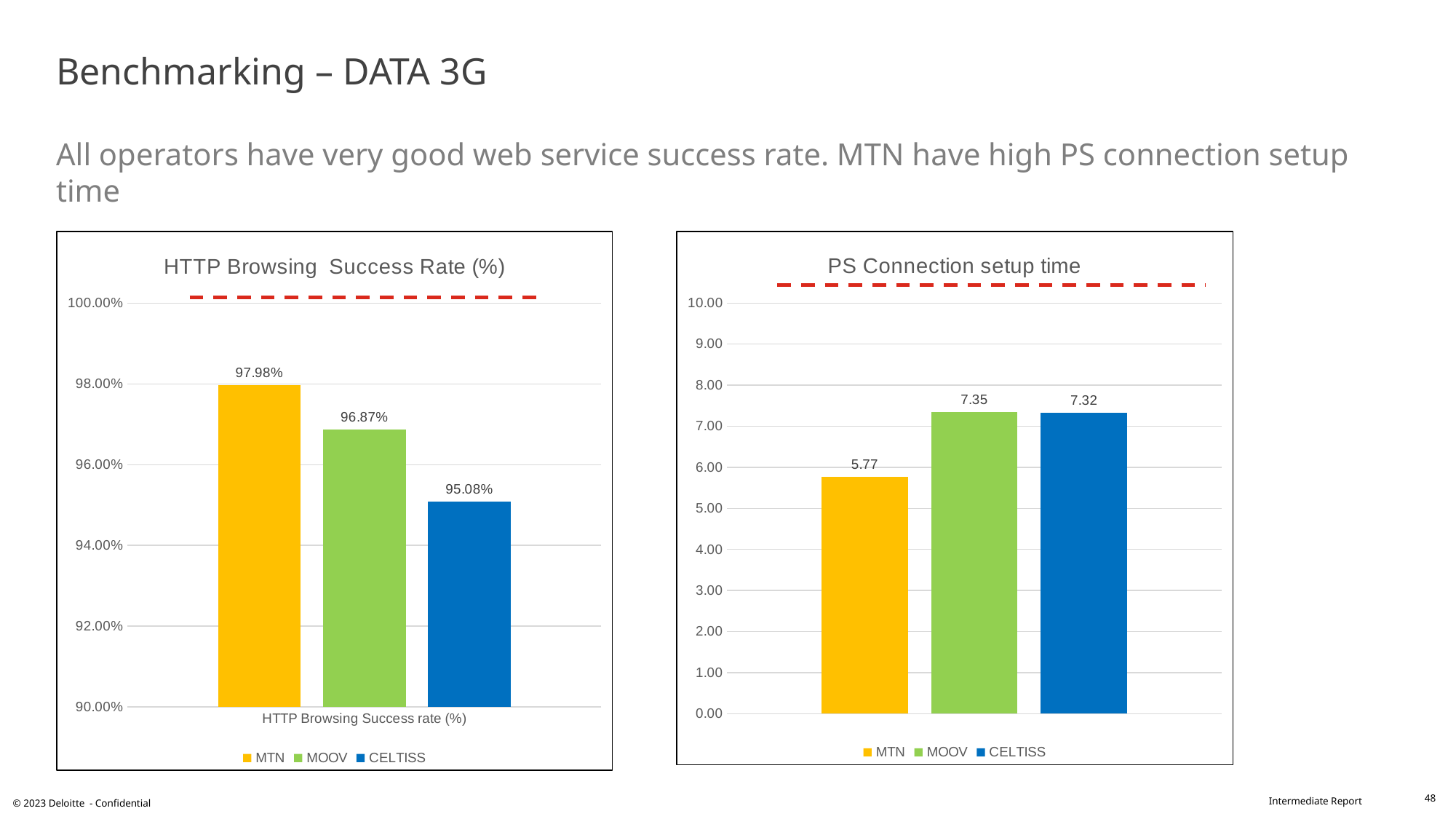
In the PS Connection setup time chart, which operator has the lowest setup time? MTN In the HTTP Browsing Success Rate (%) chart, what is the value for CELTISS? 95.08% In the HTTP Browsing Success Rate (%) chart, which operator has the lowest success rate? CELTISS What kind of chart is the HTTP Browsing Success Rate (%) chart? Bar chart In the HTTP Browsing Success Rate (%) chart, what is the difference between MTN and MOOV? 1.11% In the HTTP Browsing Success Rate (%) chart, is the value for MOOV greater or less than 96.00%? greater In the PS Connection setup time chart, is the value for CELTISS greater or less than 7.00? greater In the PS Connection setup time chart, what is the value for MOOV? 7.35 In the HTTP Browsing Success Rate (%) chart, what is the value for MTN? 97.98% In the PS Connection setup time chart, what is the value for MTN? 5.77 How many series does the legend of the PS Connection setup time chart list? 3 In the PS Connection setup time chart, what is the difference between MOOV and MTN? 1.58